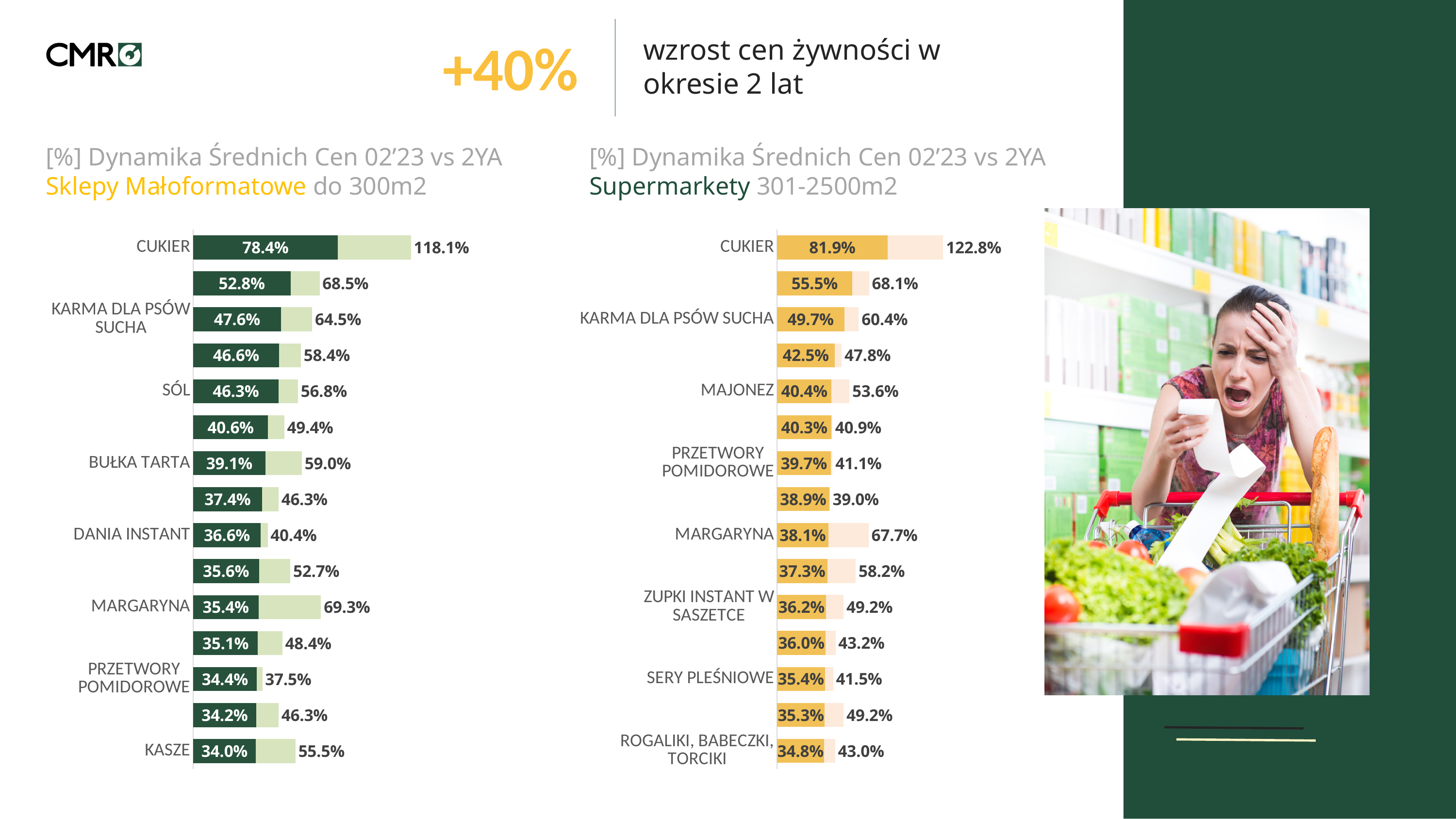
How many bars are plotted in the left chart (Sklepy Małoformatowe do 300m2)? 15 In the right chart (Supermarkety 301-2500m2), what is the value printed inside the bar for MAJONEZ? 40.4% In the left chart (Sklepy Małoformatowe do 300m2), what is the difference between the two values printed for CUKIER (118.1% and 78.4%)? 39.7 percentage points What type of chart is used on this slide? Bar chart Comparing the value printed at the end of the MARGARYNA bar in the left chart (69.3%) with that in the right chart (67.7%), which chart shows the larger value? The left chart (Sklepy Małoformatowe) In the left chart (Sklepy Małoformatowe do 300m2), which labelled category has the lowest value printed inside its bar? KASZE In the left chart (Sklepy Małoformatowe do 300m2), which category has the highest value? CUKIER In the right chart (Supermarkety 301-2500m2), what is the value printed at the end of the CUKIER bar? 122.8% In the left chart (Sklepy Małoformatowe do 300m2), what is the value printed inside the dark bar for CUKIER? 78.4% In the right chart (Supermarkety 301-2500m2), what is the value printed inside the bar for SERY PLEŚNIOWE? 35.4% In the right chart (Supermarkety 301-2500m2), which labelled category has the lowest value printed inside its bar? ROGALIKI, BABECZKI, TORCIKI In the left chart (Sklepy Małoformatowe do 300m2), what is the value printed at the end of the CUKIER bar? 118.1%